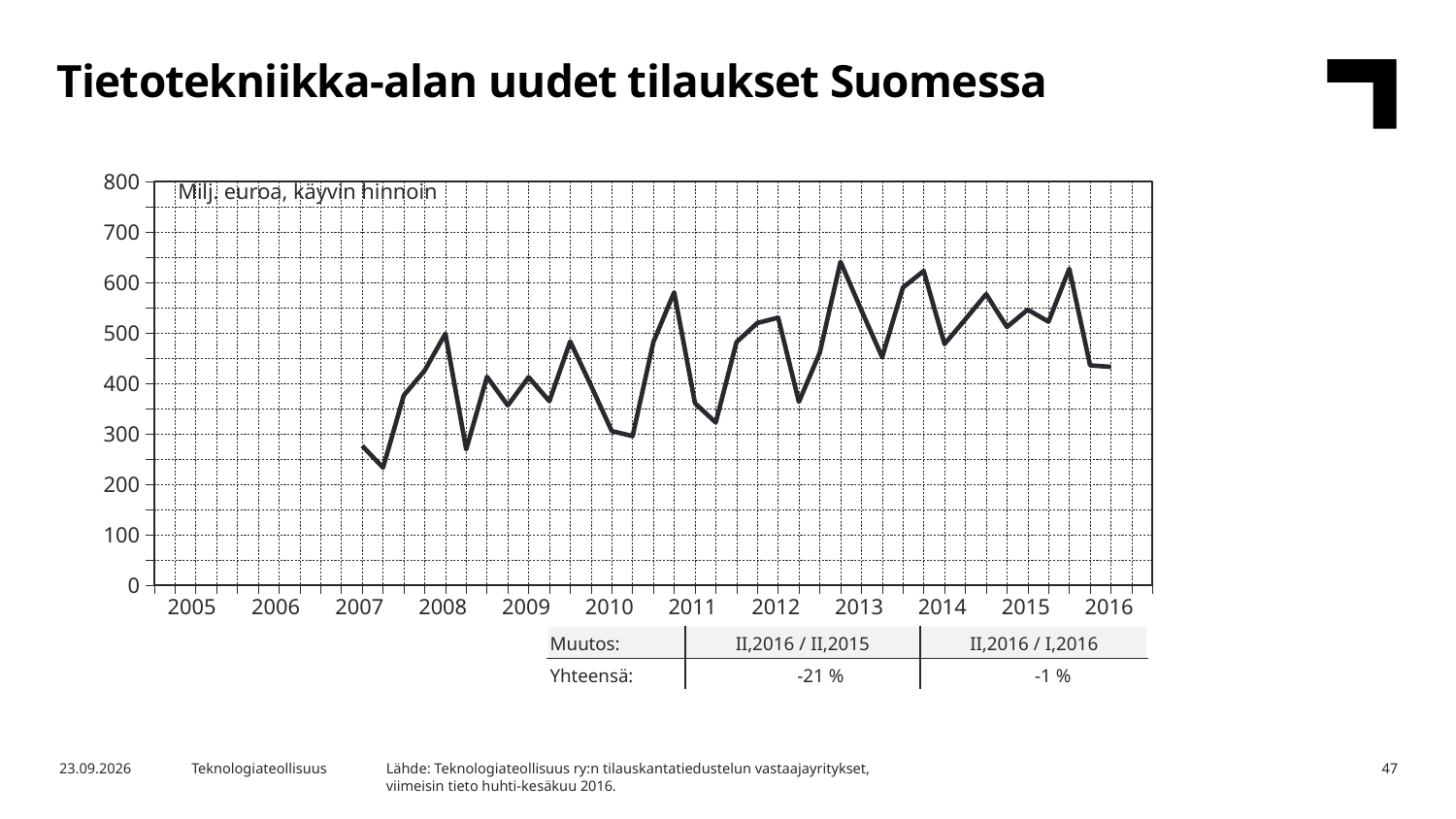
What is the highest value shown on the y axis? 800 According to the table below the chart, what is the change for II,2016 / II,2015? -21 % Is the peak value of the line around the start of 2013 greater or less than 600? greater Is the first plotted value at the start of 2007 greater or less than 300? less According to the table below the chart, what is the change for II,2016 / I,2016? -1 % What kind of chart is shown on the slide? line chart Does the line rise or fall between the end of 2015 and 2016? fall How many year labels are shown on the x axis? 12 What unit label is shown inside the chart area? Milj. euroa, käyvin hinnoin What is the title of the chart? Tietotekniikka-alan uudet tilaukset Suomessa Is the last plotted value in 2016 greater or less than 500? less